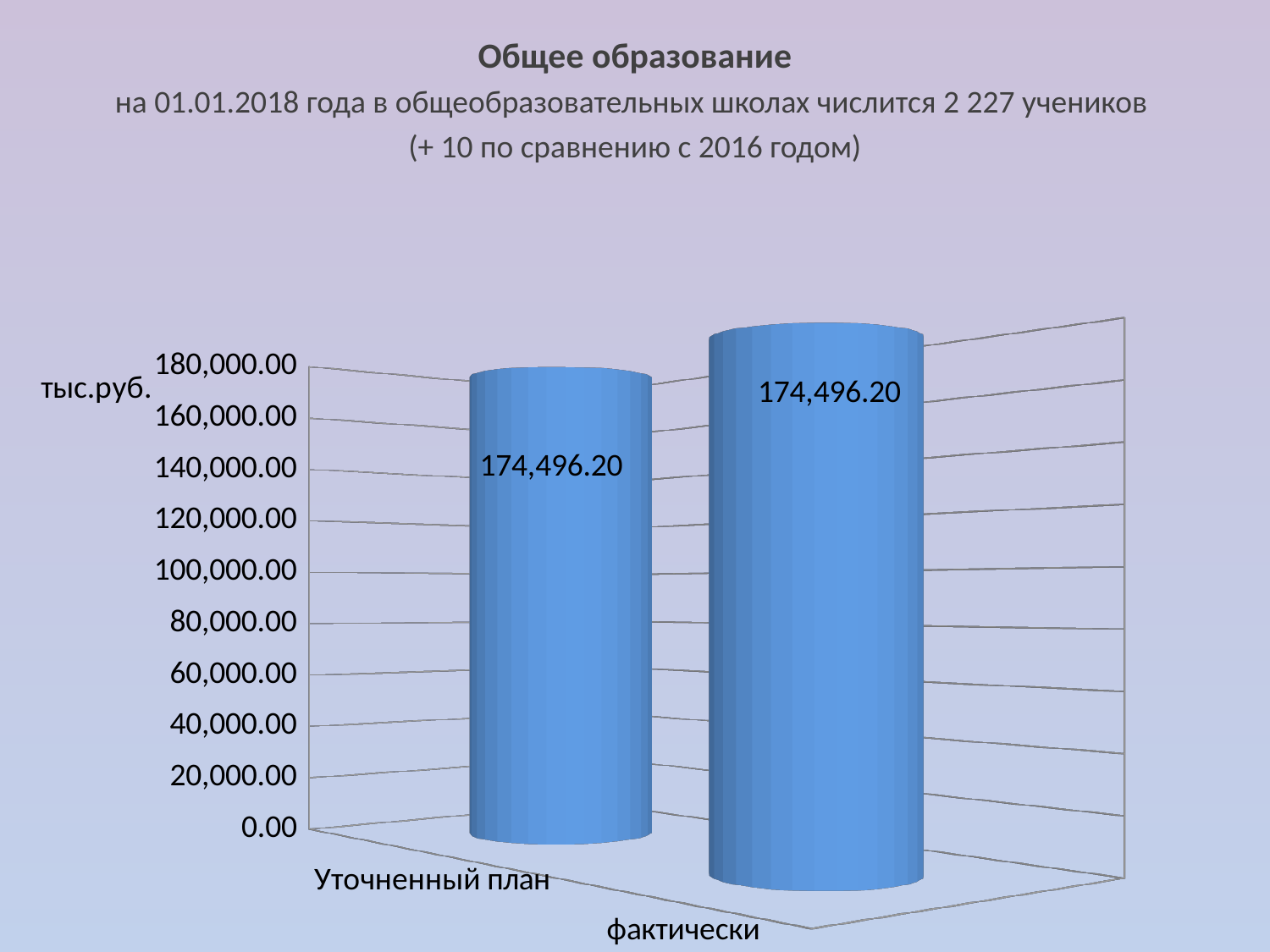
Do the values change from Уточненный план to фактически? No, they stay the same How many categories are shown on the chart? 2 What unit is shown on the vertical axis of the chart? тыс.руб. What is the value for фактически? 174,496.20 Is the value for фактически larger than, smaller than, or equal to the value for Уточненный план? equal Is the value for Уточненный план greater or less than 160,000.00? greater What is the value for Уточненный план? 174,496.20 Is the value for фактически greater or less than 180,000.00? less What kind of chart is shown on the slide? bar chart What is the difference between the values for Уточненный план and фактически? 0.00 What is the highest tick value shown on the vertical axis? 180,000.00